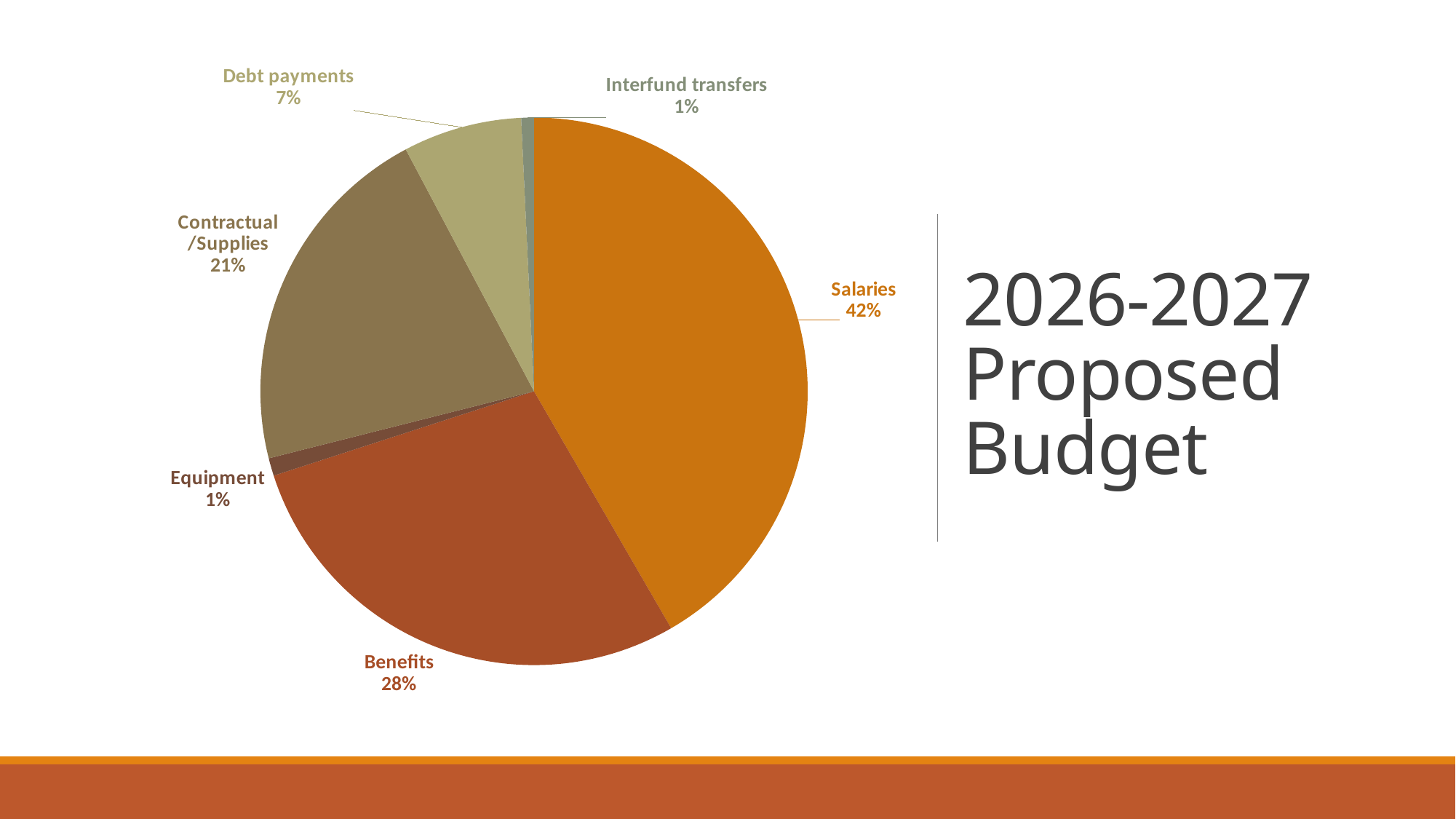
What share of the pie does Salaries represent? 42% Which is larger, Benefits or Contractual/Supplies? Benefits What is the title text shown next to the chart? 2026-2027 Proposed Budget What share of the pie does Equipment represent? 1% What share of the pie does Contractual/Supplies represent? 21% What is the difference in percentage points between Salaries and Benefits? 14 How many categories are shown in the pie chart? 6 What kind of chart is shown on the slide? Pie chart What is the difference in percentage points between Contractual/Supplies and Debt payments? 14 Which category has the largest slice of the pie? Salaries